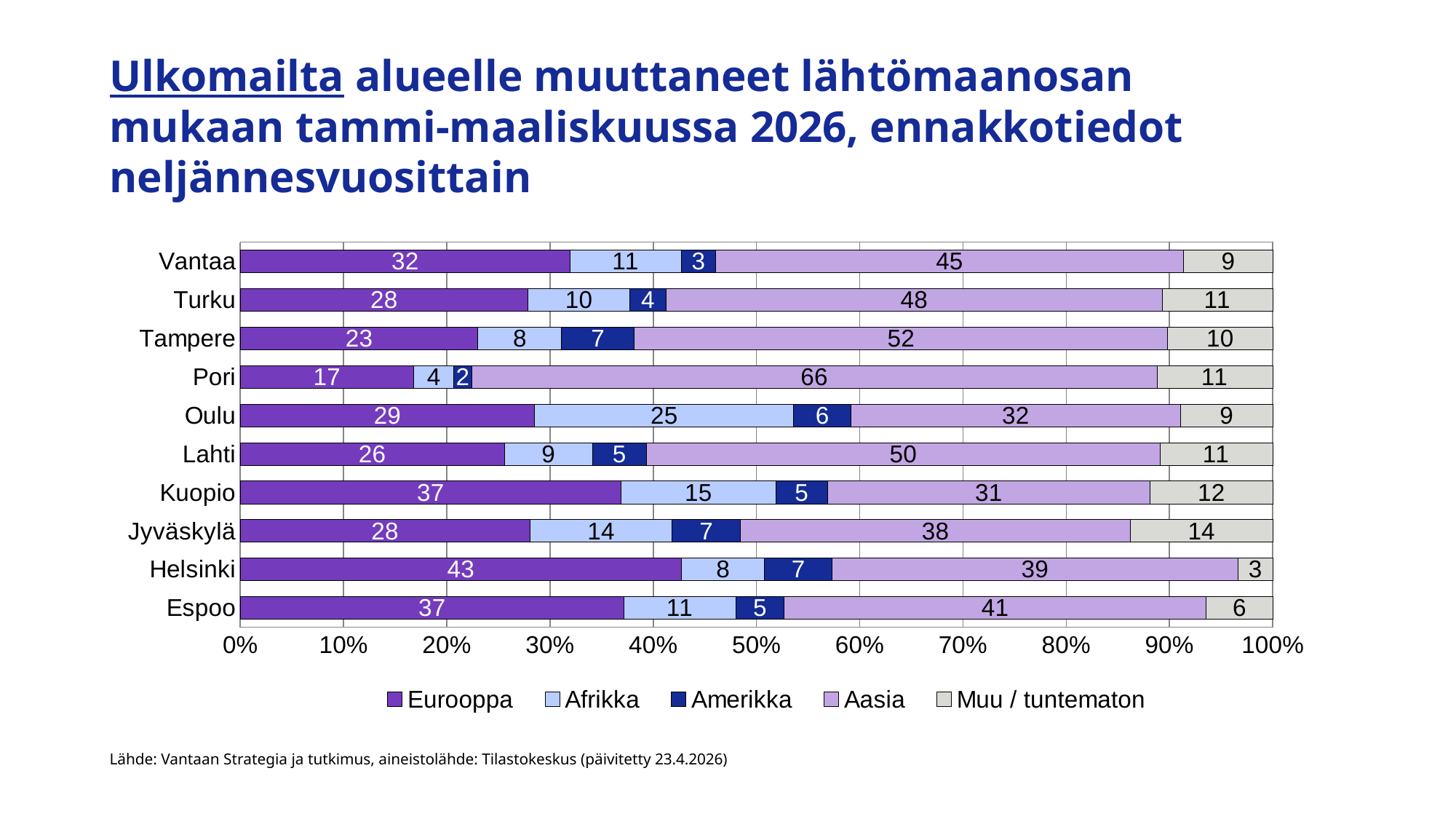
What is the value for Muu / tuntematon for Jyväskylä? 14 What is the difference between the Aasia value for Pori and the Aasia value for Vantaa? 21 What is the value for Eurooppa for Helsinki? 43 Which city has the lowest value for Muu / tuntematon? Helsinki How many cities are shown on the chart? 10 Which city has the highest value for Aasia? Pori How many series does the legend list? 5 What kind of chart is shown on the slide? Stacked bar chart Which series is shown in the lightest grey colour in the legend? Muu / tuntematon What is the value for Aasia for Pori? 66 Which is larger, the Eurooppa value for Kuopio or the Eurooppa value for Jyväskylä? Kuopio What is the value for Afrikka for Oulu? 25